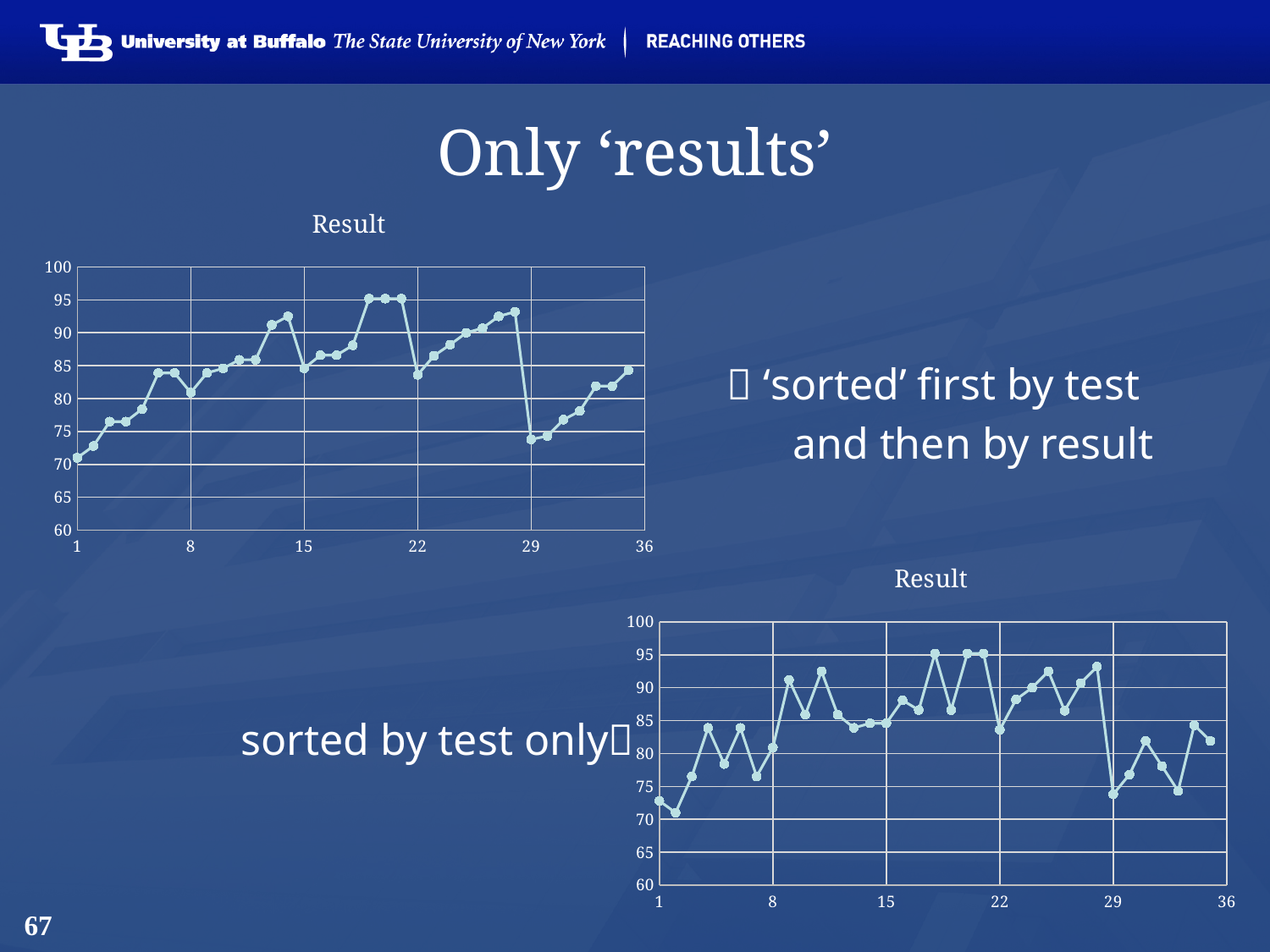
In the top-left chart, do the values rise or fall between x = 29 and x = 36? rise In the top-left chart, is the value at x = 22 greater or less than 80? greater What kind of chart is the top-left chart on the slide? line chart In the bottom-right chart, is the value at x = 29 greater or less than 80? less In the top-left chart, is the value at x = 29 greater or less than 80? less What is the title of the top-left chart? Result What is the highest value shown on the y axis of the bottom-right chart? 100 What kind of chart is the bottom-right chart on the slide? line chart